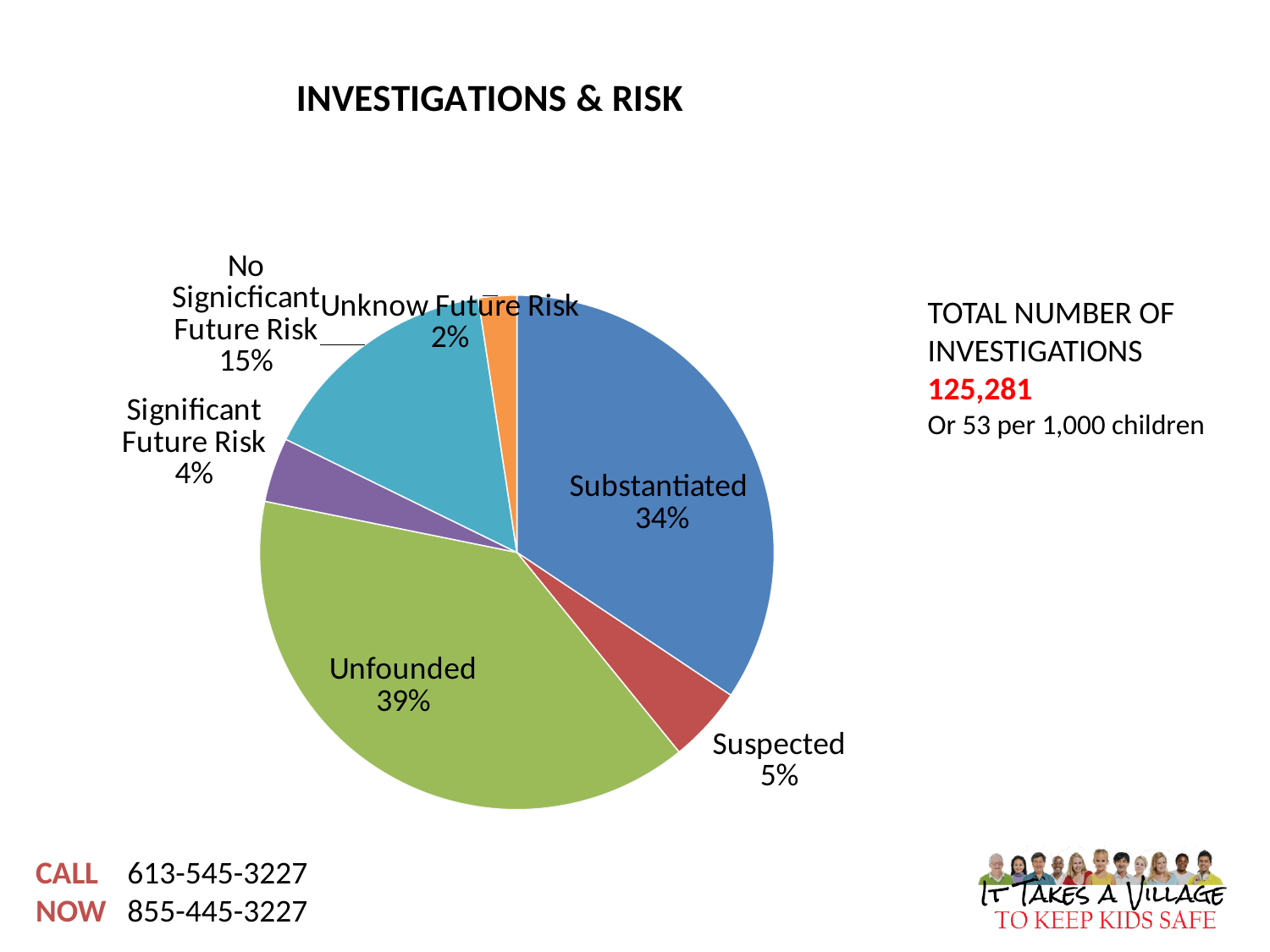
Which slice of the pie is the largest? Unfounded What kind of chart is shown on the slide? pie chart What share of the pie is Unfounded? 39% What is the difference in percentage points between Unfounded and Substantiated? 5 What share of the pie is Substantiated? 34% What share of the pie is No Significant Future Risk? 15% What share of the pie is Suspected? 5% What is the title of the slide containing the pie chart? INVESTIGATIONS & RISK What share of the pie is Significant Future Risk? 4% Which is larger, Suspected or Significant Future Risk? Suspected How many slices does the pie chart have? 6 Which slice of the pie is the smallest? Unknown Future Risk